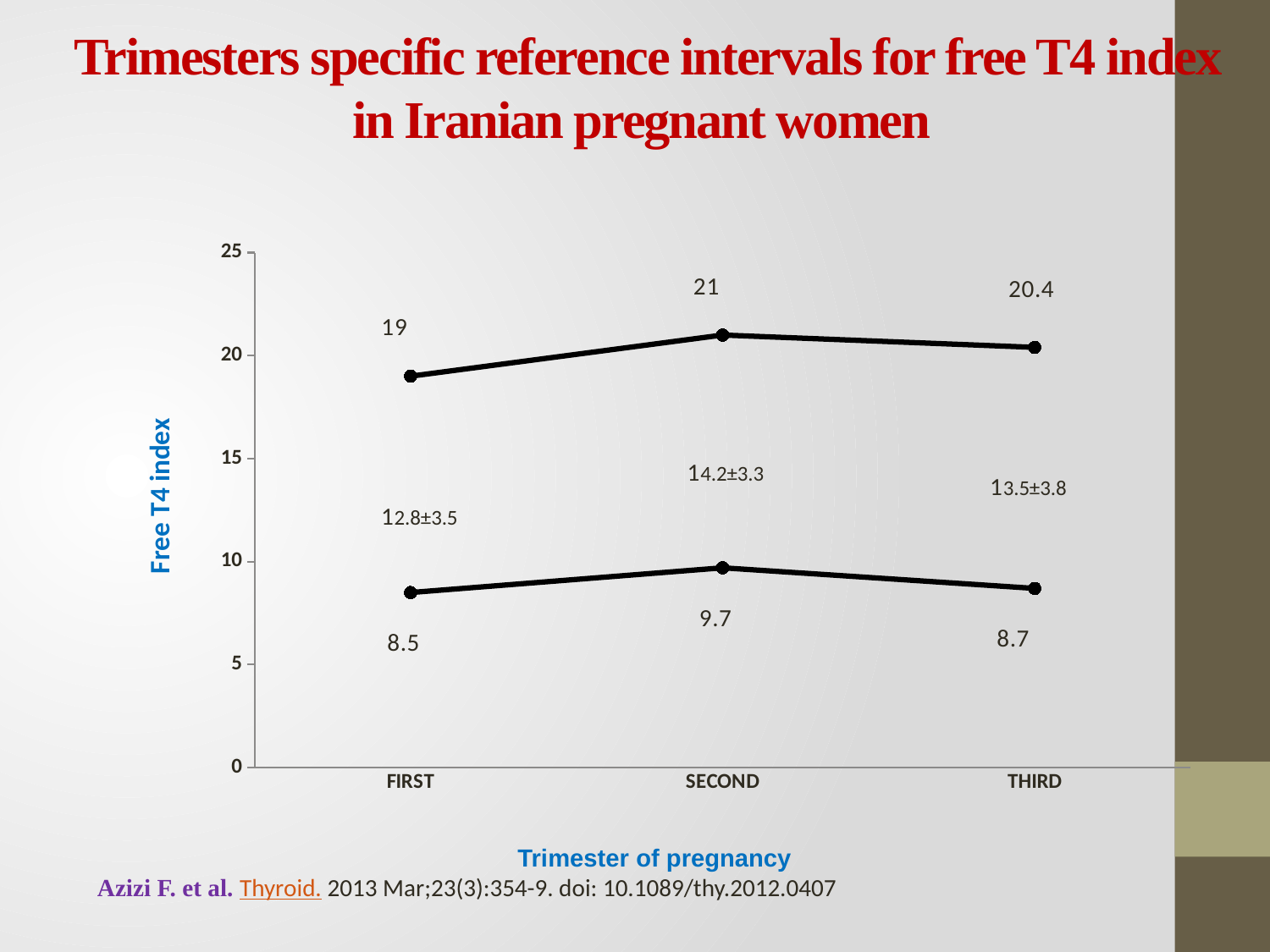
What is the title of the y axis? Free T4 index Is the upper line's value for the FIRST trimester greater or less than 20? less What mean value (with its ± range) is printed for the SECOND trimester? 14.2±3.3 What kind of chart is shown on the slide? Line chart What is the lower line's value for the FIRST trimester? 8.5 In which trimester does the upper line reach its highest value? SECOND How many trimester categories are shown on the x axis? 3 What is the upper line's value for the THIRD trimester? 20.4 Which is larger, the lower line's value for the SECOND trimester or for the THIRD trimester? SECOND What is the upper line's value for the SECOND trimester? 21 In which trimester does the lower line have its lowest value? FIRST What is the difference between the upper line's values for the SECOND and FIRST trimesters? 2